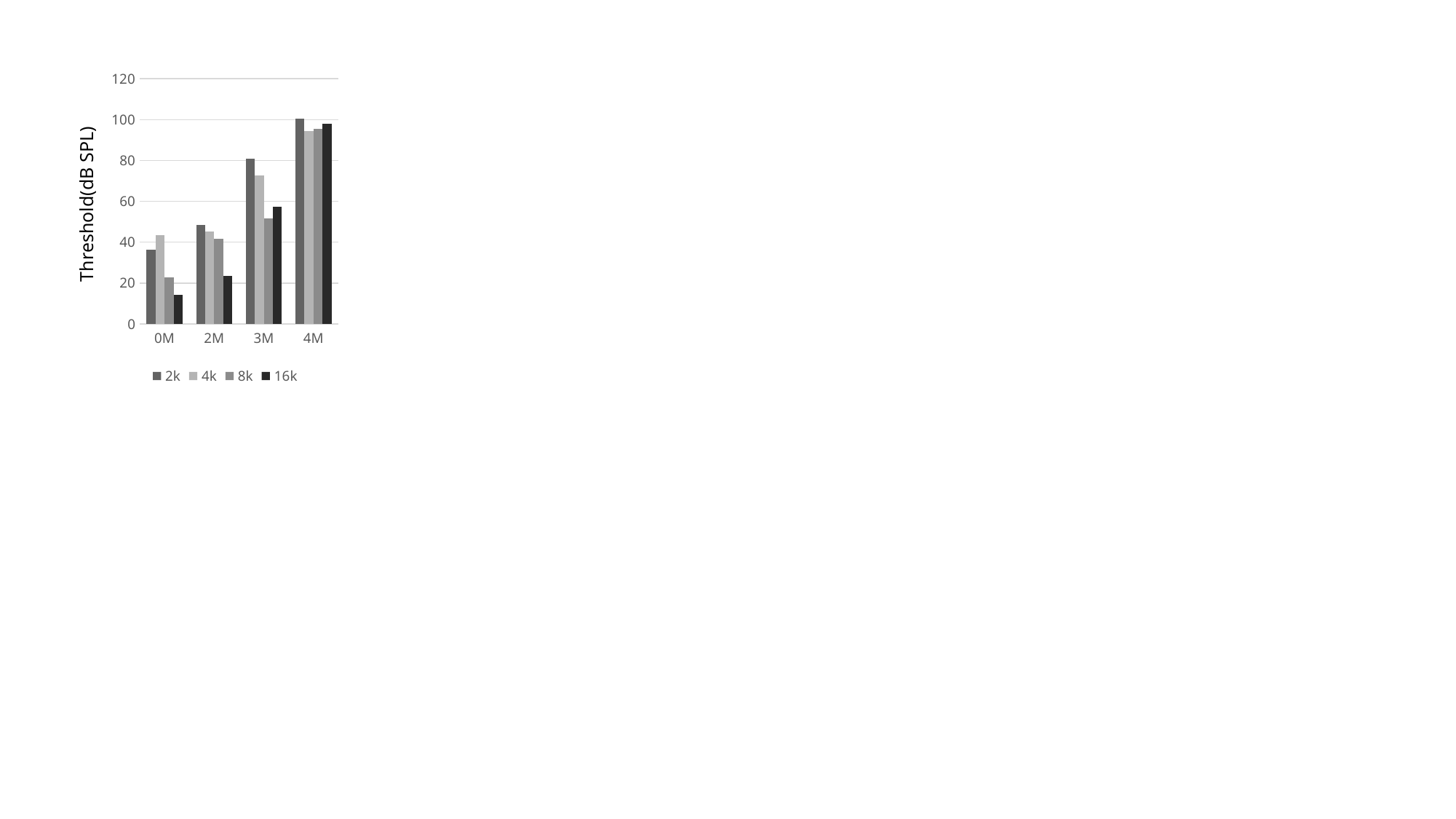
At 3M, which is larger: the value for 2k or the value for 8k? 2k Do the values for the 2k series rise or fall from 0M to 4M? rise Is the value for 16k at 2M greater or less than 40? less How many categories are shown on the x axis? 4 What kind of chart is shown on the slide? bar chart What is the y-axis title of the chart? Threshold(dB SPL) Which category has the highest value for the 2k series? 4M How many series does the legend list? 4 Is the value for 16k at 0M greater or less than 20? less Which category has the lowest value for the 16k series? 0M